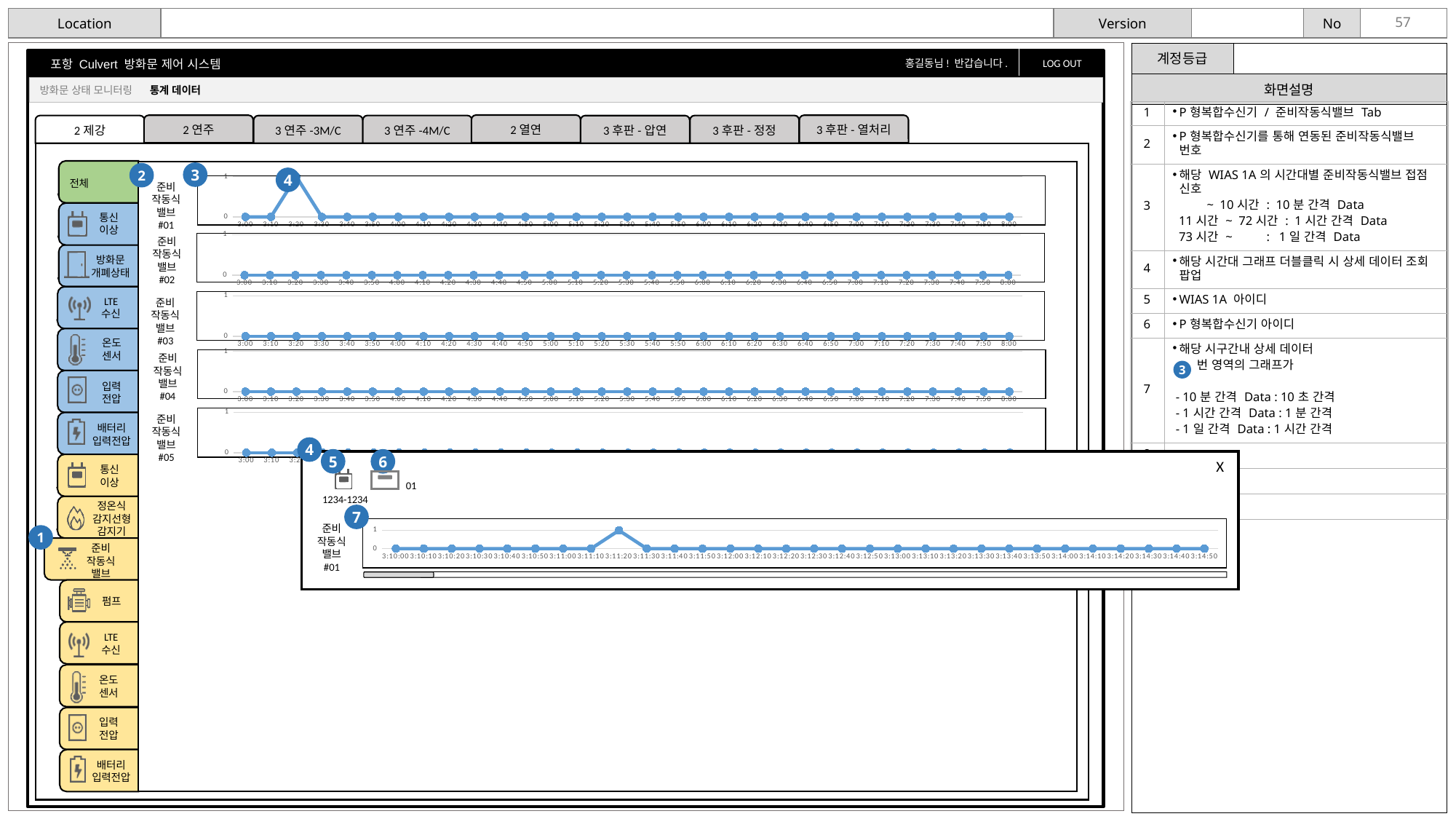
In the top chart (준비작동식밸브 #01) of the main panel, what is the value at 3:00? 0 In the top chart (준비작동식밸브 #01) of the main panel, at which time does the line reach the value 1? 3:20 In the top chart (준비작동식밸브 #01) of the main panel, what is the value at 3:20? 1 In the top chart (준비작동식밸브 #01) of the main panel, which has the larger value: 3:10 or 3:20? 3:20 How many 준비작동식밸브 line charts are stacked in the main panel behind the popup? 5 In the popup chart (준비작동식밸브 #01) at the bottom, what is the value at 3:10:00? 0 What is the first time label on the x axis of the popup chart at the bottom? 3:10:00 What is the highest tick shown on the y axis of the 준비작동식밸브 charts in the main panel? 1 In the popup chart (준비작동식밸브 #01) at the bottom, at which time does the line reach the value 1? 3:11:20 In the top chart (준비작동식밸브 #01) of the main panel, what is the difference between the value at 3:20 and the value at 3:10? 1 In the 준비작동식밸브 #02 chart of the main panel, do the values rise, fall, or stay flat across the x axis? stay flat What kind of chart is used for the 준비작동식밸브 #01 graph at the top of the main panel? line chart